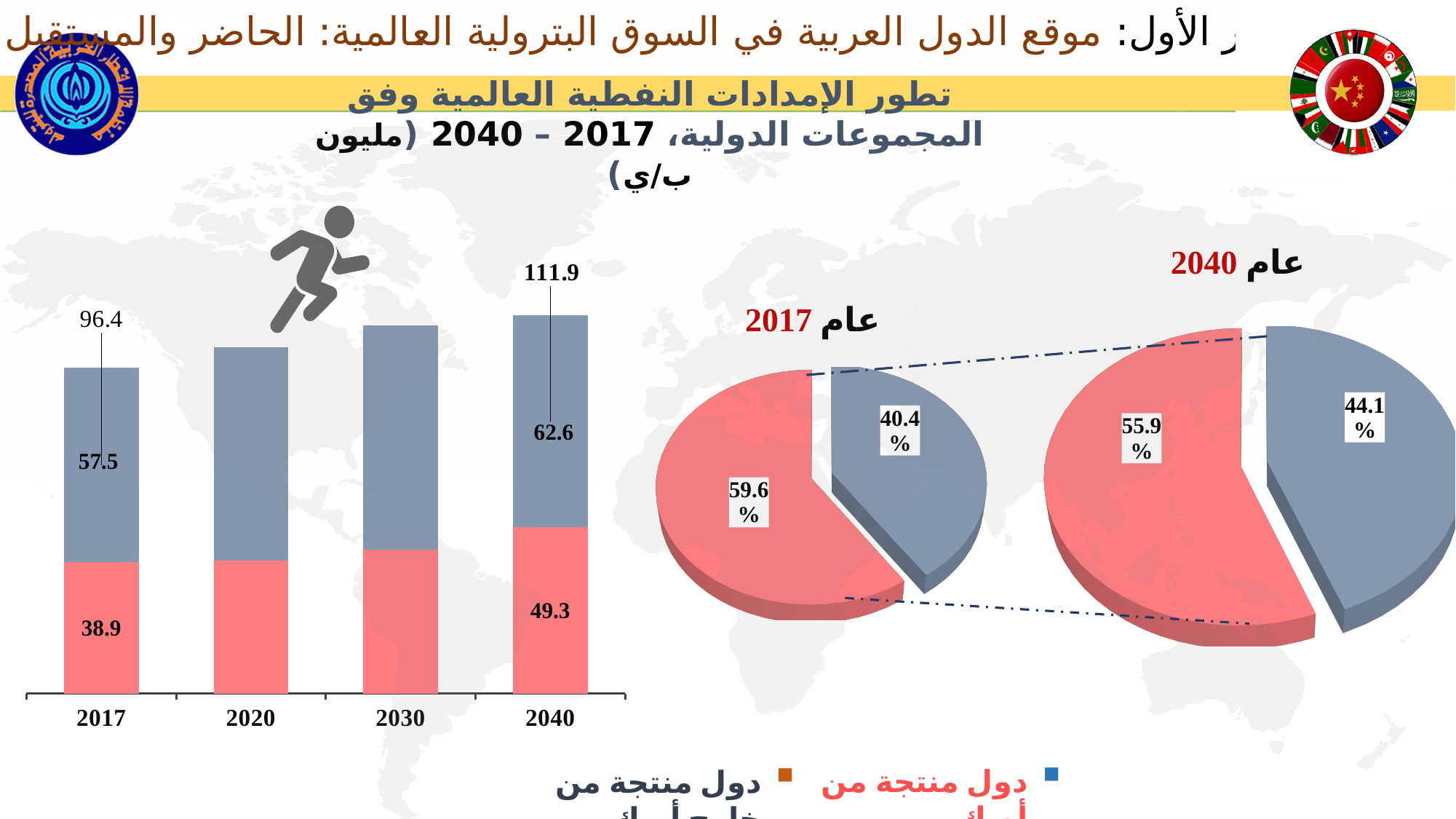
What kind of chart is shown on the left side of the slide? stacked bar chart In the stacked bar chart on the left, do the total bar heights rise or fall from 2017 to 2040? rise In the 2040 pie chart (عام 2040), what share does the blue slice have? 44.1% In the stacked bar chart on the left, what is the total value shown above the 2017 bar? 96.4 In the stacked bar chart on the left, which year has the tallest bar? 2040 In the stacked bar chart on the left, what is the difference between the red segment values for 2040 and 2017? 10.4 In the stacked bar chart on the left, what is the value of the red (lower) segment for 2017? 38.9 Comparing the two pie charts, is the blue slice larger in 2017 or in 2040? 2040 In the stacked bar chart on the left, what is the total value shown above the 2040 bar? 111.9 In the stacked bar chart on the left, what is the value of the blue (upper) segment for 2040? 62.6 In the 2017 pie chart (عام 2017), what share does the red slice have? 59.6% In the stacked bar chart on the left, how many years are shown on the x axis? 4